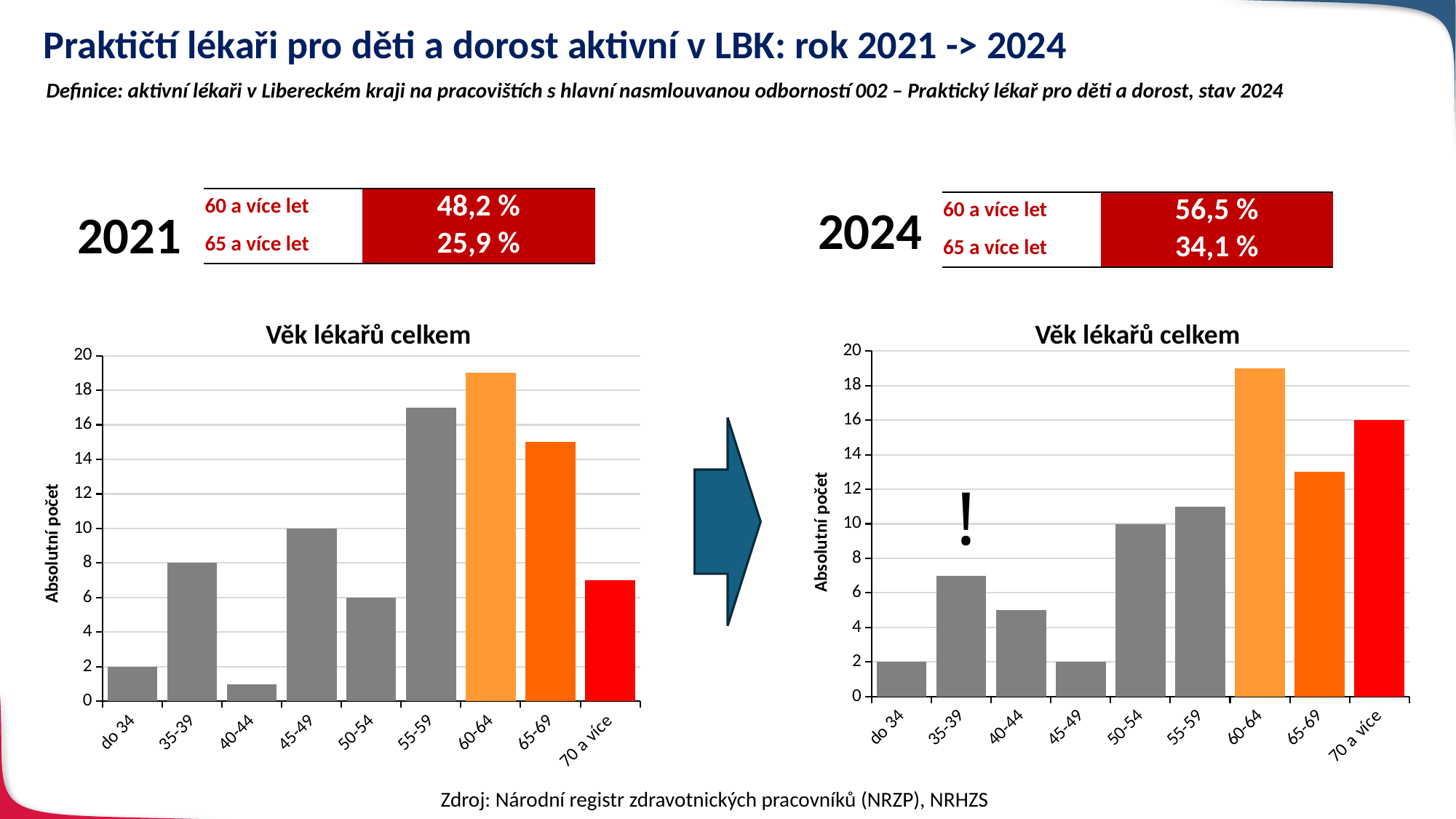
In the 2021 chart (left), what is the difference between the values for 45-49 and do 34? 8 In the 2021 chart (left), which age group has the highest value? 60-64 In the 2021 chart (left), what is the value for the 45-49 age group? 10 In the 2024 chart (right), what is the value for the 70 a více age group? 16 What kind of chart is the 2021 chart (left)? bar chart In the 2024 chart (right), which age group has the highest value? 60-64 How many age categories are shown on the x axis of the 2024 chart (right)? 9 In the 2021 chart (left), which age group has the lowest value? 40-44 In the 2024 chart (right), is the value for 65-69 greater or less than 14? less In the 2021 chart (left), is the value for 55-59 greater or less than 16? greater What is the y-axis label of the 2024 chart (right)? Absolutní počet In the 2024 chart (right), which is larger, the value for 70 a více or the value for 65-69? 70 a více